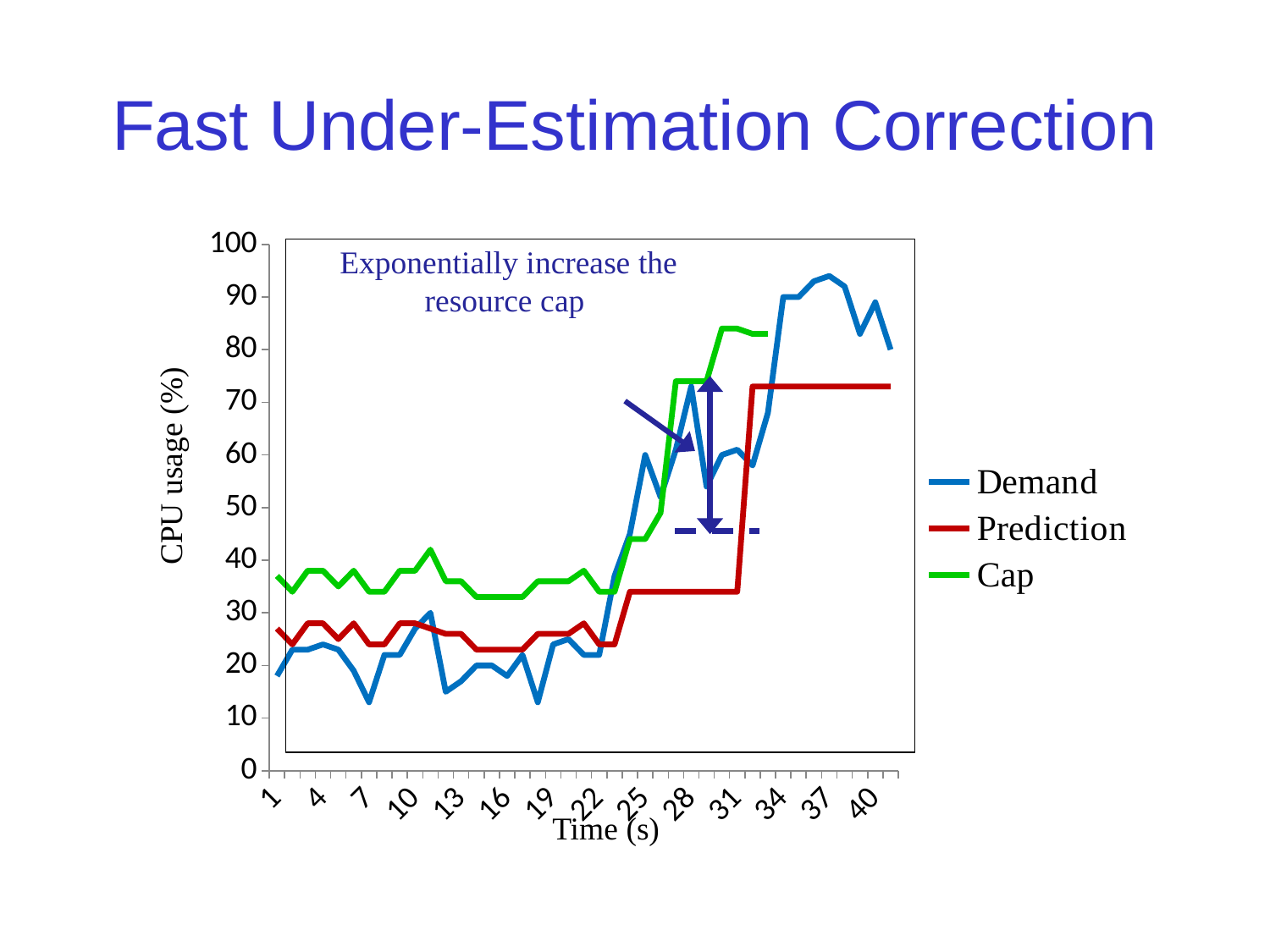
At time 37, which series has the higher value, Demand or Prediction? Demand Is the Demand value at time 7 greater or less than 20? less Is the Cap value at time 16 greater or less than 40? less Is the Demand value at time 37 greater or less than 90? greater What is the label of the y axis? CPU usage (%) What are the three series named in the legend? Demand, Prediction, Cap How many series does the legend list? 3 What kind of chart is shown on the slide? line chart At time 10, which series has the higher value, Cap or Demand? Cap Does the Prediction series rise or fall overall from time 1 to time 40? rise